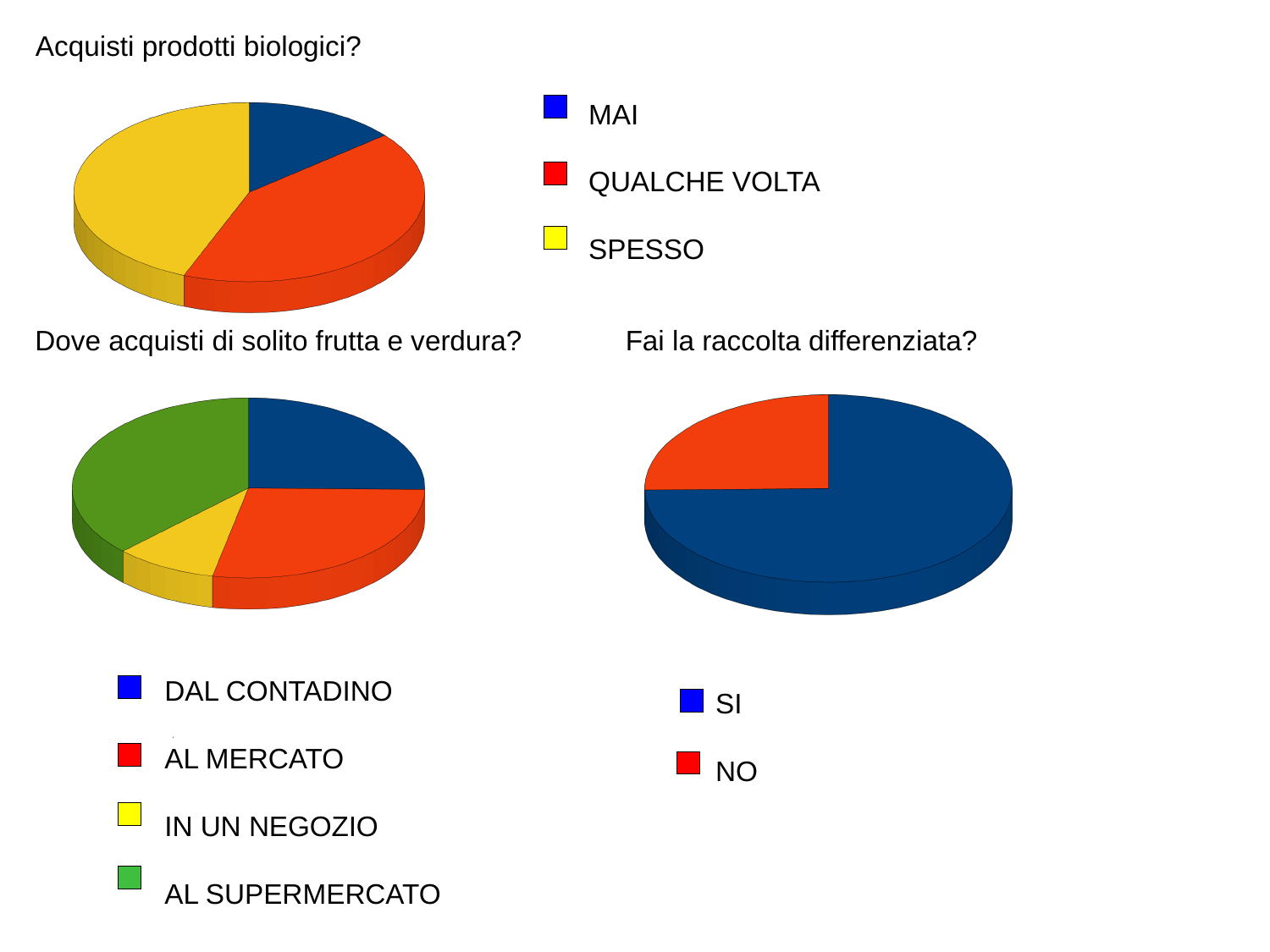
How many pie charts are on the slide? 3 In the "Dove acquisti di solito frutta e verdura?" chart, which category has the smallest slice? IN UN NEGOZIO In the "Acquisti prodotti biologici?" chart, how many categories does the legend list? 3 In the "Dove acquisti di solito frutta e verdura?" chart, how many categories are shown? 4 In the "Dove acquisti di solito frutta e verdura?" chart, which slice is larger, IN UN NEGOZIO or AL SUPERMERCATO? AL SUPERMERCATO What kind of chart is used for "Acquisti prodotti biologici?"? Pie chart In the "Fai la raccolta differenziata?" chart, which category has the largest slice? SI In the "Acquisti prodotti biologici?" chart, which category has the smallest slice? MAI In the "Acquisti prodotti biologici?" chart, what colour is the SPESSO slice? Yellow In the "Acquisti prodotti biologici?" chart, which slice is larger, MAI or QUALCHE VOLTA? QUALCHE VOLTA In the "Dove acquisti di solito frutta e verdura?" chart, which category has the largest slice? AL SUPERMERCATO In the "Fai la raccolta differenziata?" chart, how many categories does the legend list? 2